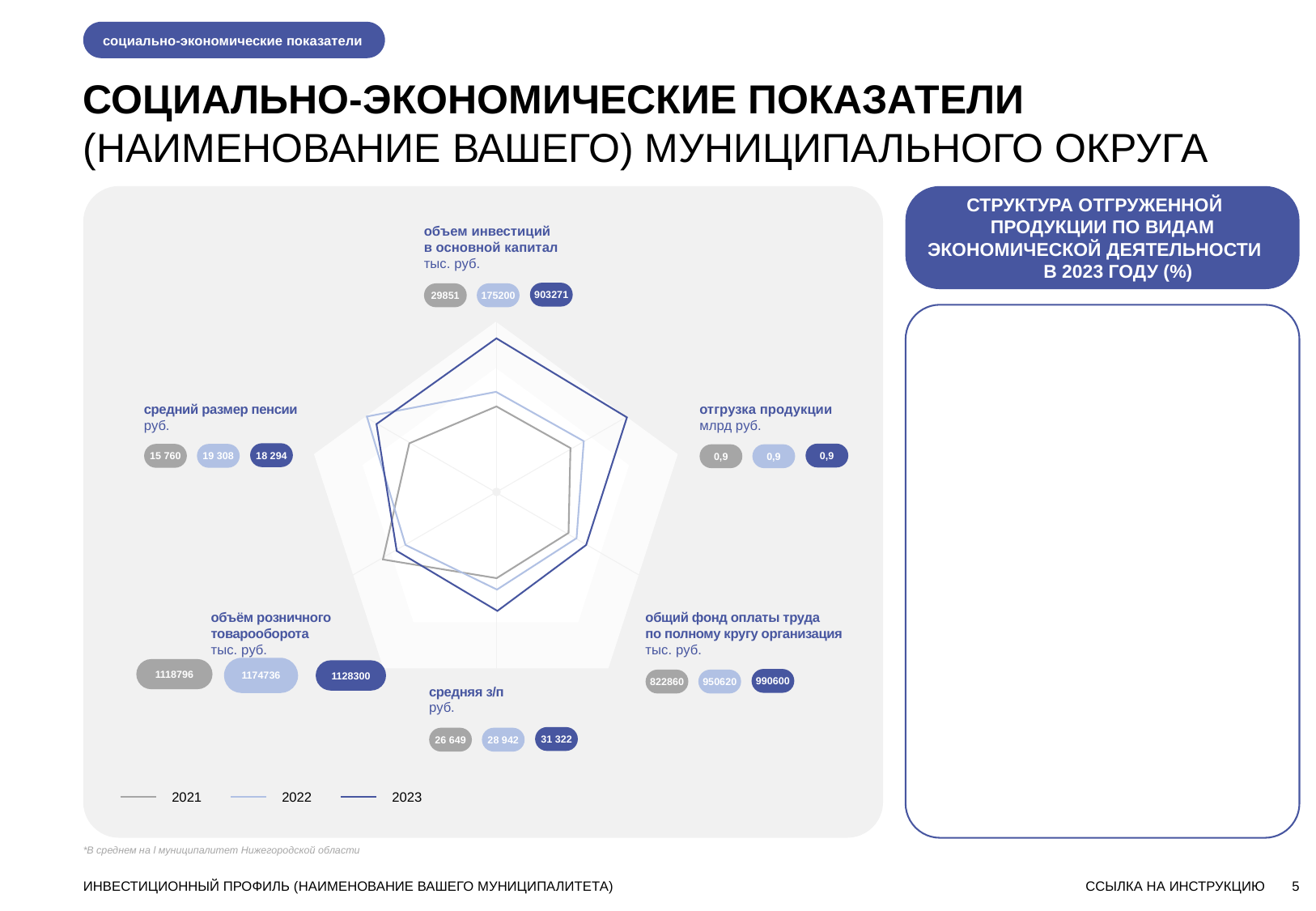
Does the value for объем инвестиций в основной капитал rise or fall from 2021 to 2023? rise What is the 2023 value for общий фонд оплаты труда по полному кругу организация? 990600 What is the 2023 value for объем инвестиций в основной капитал? 903271 How many indicators (axes) does the radar chart have? 6 Which year has the larger value for средний размер пенсии, 2022 or 2023? 2022 By how much did средняя з/п increase from 2021 to 2023? 4 673 What is the 2022 value for средний размер пенсии? 19 308 What kind of chart is shown on the left of the slide? radar chart Which years are listed in the legend of the radar chart? 2021, 2022, 2023 What is the 2021 value for средняя з/п? 26 649 What is the value for отгрузка продукции in 2021? 0,9 How many series does the legend of the radar chart list? 3